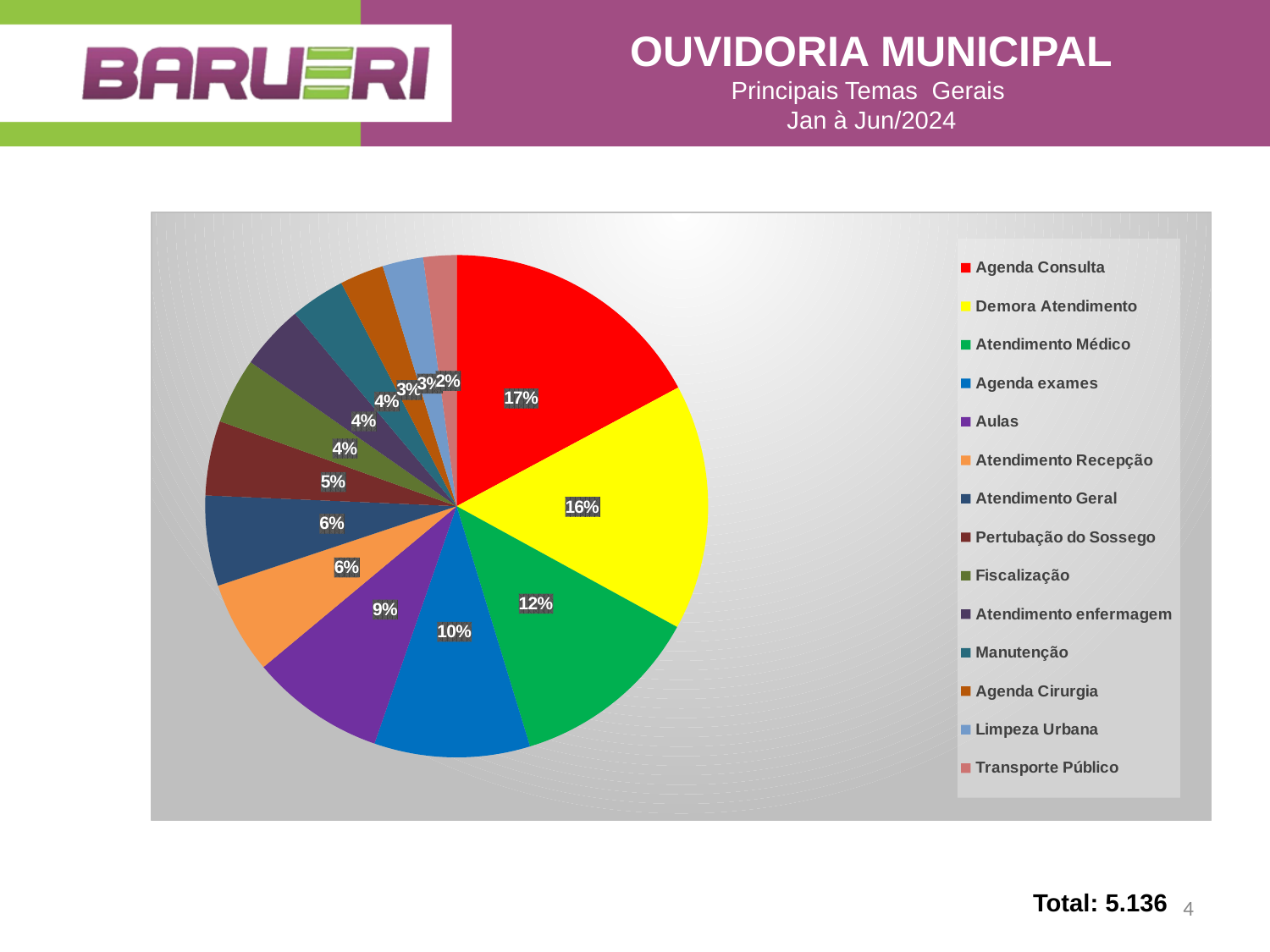
What kind of chart is shown on the slide? Pie chart What share of the pie does Demora Atendimento represent? 16% How many categories does the legend list? 14 What is the value shown for Transporte Público? 2% Which category has the smallest slice of the pie? Transporte Público Which is larger, the share for Aulas or the share for Pertubação do Sossego? Aulas Which category has the largest slice of the pie? Agenda Consulta What is the value shown for Aulas? 9% What is the value shown for Atendimento Médico? 12% What is the value shown for Agenda exames? 10% What share of the pie does Agenda Consulta represent? 17% What is the difference between the shares of Agenda Consulta and Atendimento Médico? 5%